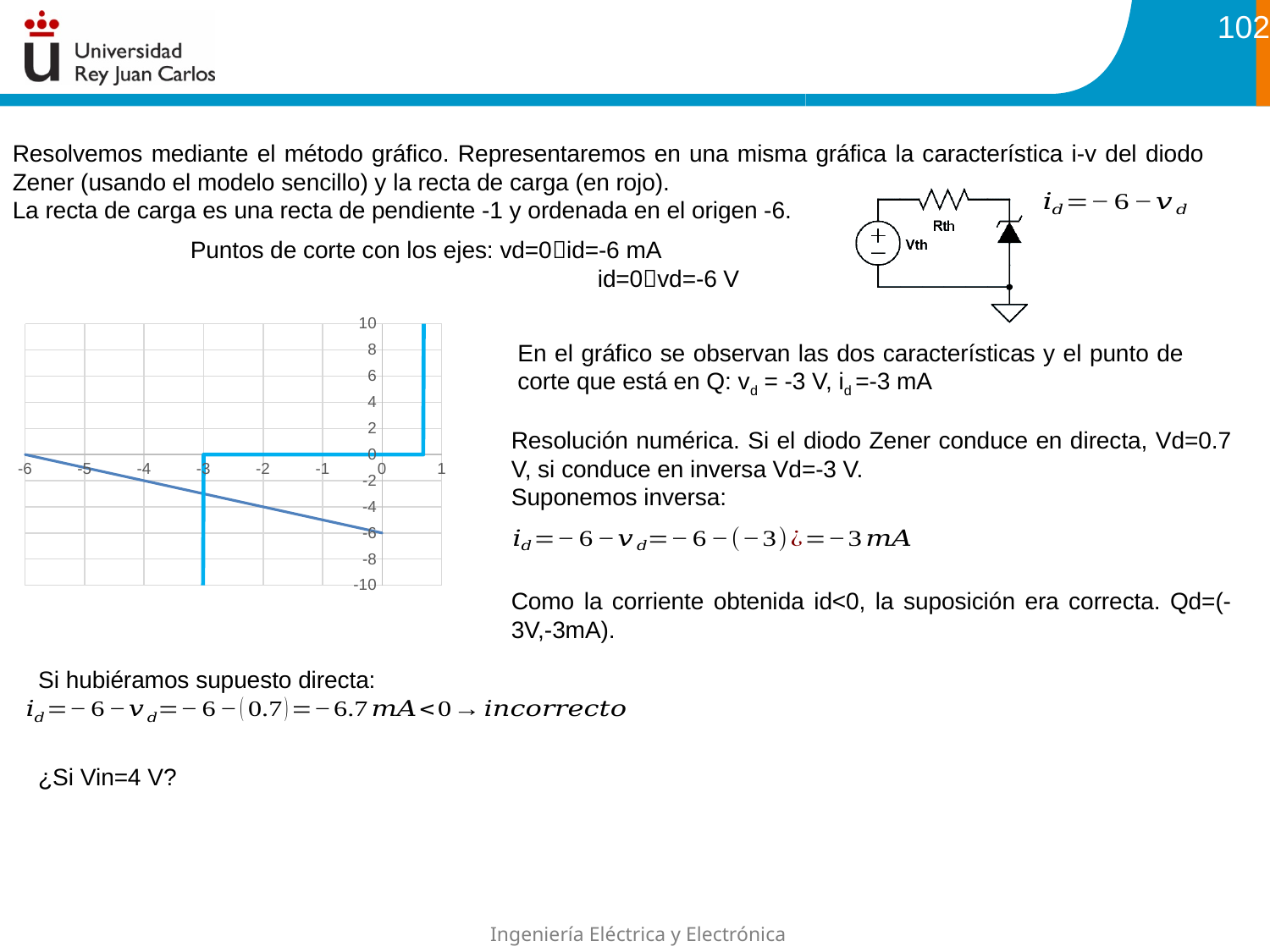
At what x value does the cyan line drop vertically downward? -3 How many tick labels are shown on the horizontal axis? 8 What is the highest tick value shown on the vertical axis? 10 Which line is higher at x = 0, the cyan line or the blue load line? cyan line At what x value does the blue load line cross the horizontal axis (y = 0)? -6 Does the blue load line rise or fall as the x value increases from -6 to 1? fall What is the lowest tick value shown on the horizontal axis? -6 Is the value of the blue load line at x = -2 greater or less than -2? less What is the value of the blue load line at x = 0? -6 What kind of chart is shown on the left of the slide? line chart Is the value of the blue load line at x = -5 greater or less than -2? greater How many lines are plotted on the chart? 2